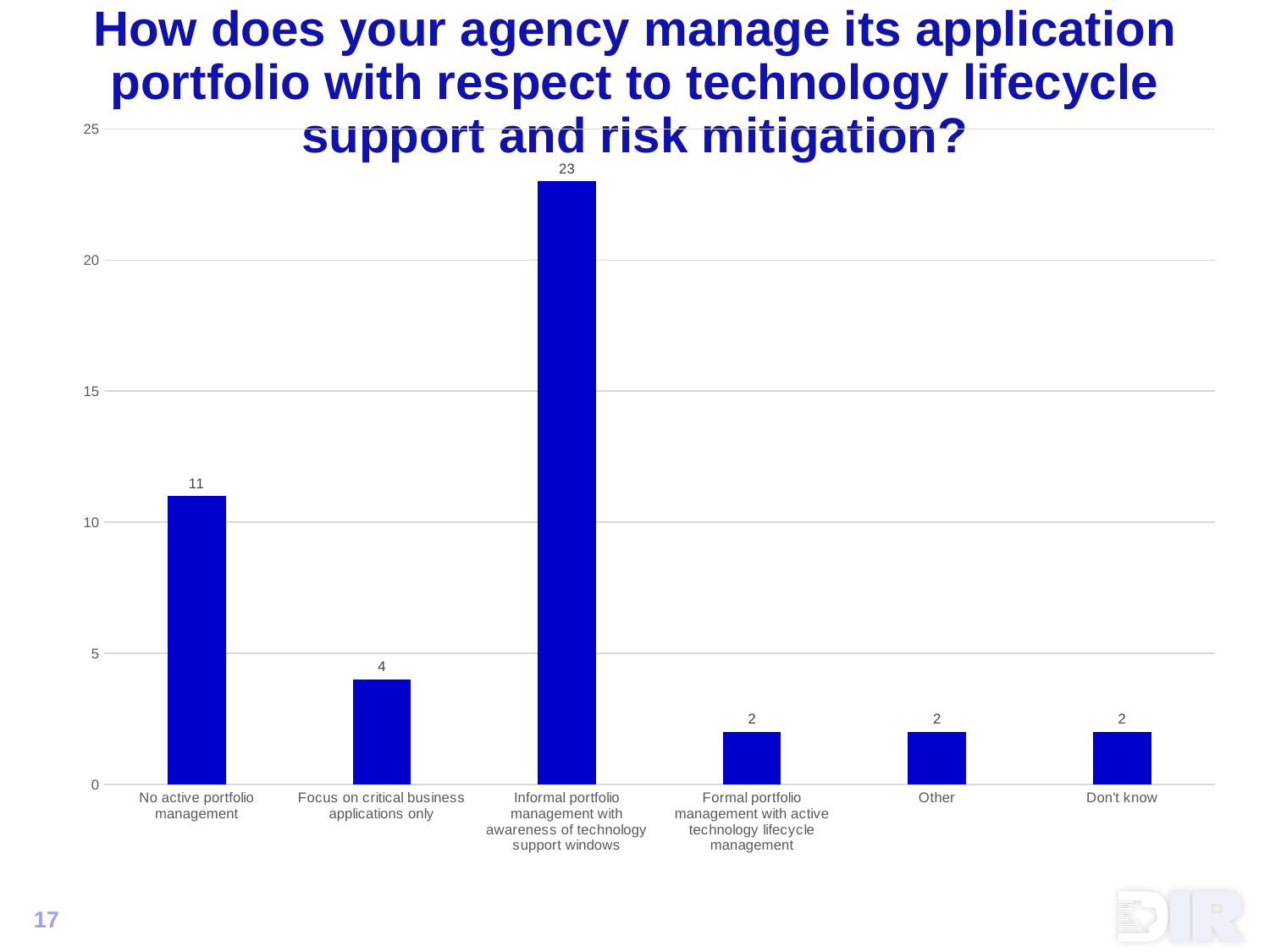
How many categories have a value of 2? 3 Which category has the highest value? Informal portfolio management with awareness of technology support windows What is the difference between the values for "Focus on critical business applications only" and "Other"? 2 Which is larger, the value for "No active portfolio management" or the value for "Focus on critical business applications only"? No active portfolio management How many categories are shown on the x axis? 6 What is the value for "No active portfolio management"? 11 What is the value for "Focus on critical business applications only"? 4 What is the value for "Informal portfolio management with awareness of technology support windows"? 23 What is the value for "Don't know"? 2 What is the difference between the values for "Informal portfolio management with awareness of technology support windows" and "No active portfolio management"? 12 Is the value for "Informal portfolio management with awareness of technology support windows" greater or less than 20? greater What kind of chart is shown on the slide? bar chart